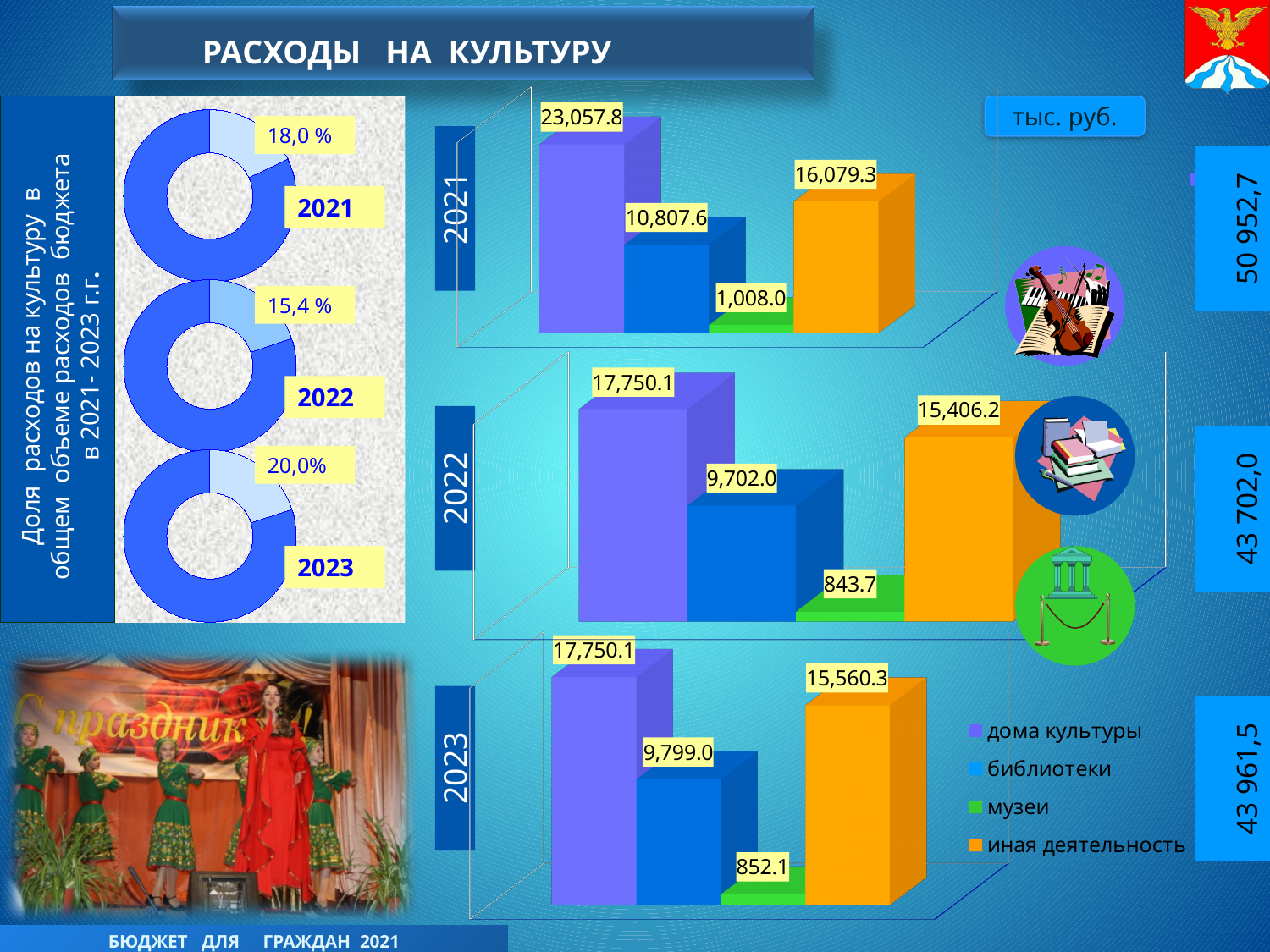
In the 2023 bar chart, what is the value for музеи? 852.1 In the 2022 bar chart, which category has the lowest value? музеи In the 2021 bar chart, what is the value for дома культуры? 23,057.8 In the 2021 bar chart, which category has the highest value? дома культуры What kind of chart is used to show the 2022 culture expenditures by category? bar chart In the donut chart for 2023, what share of total budget expenditures goes to culture? 20,0% In the 2023 bar chart, which is larger: библиотеки or иная деятельность? иная деятельность In the 2023 bar chart, what is the value for иная деятельность? 15,560.3 In the donut chart for 2022, what share of total budget expenditures goes to culture? 15,4 % In the 2021 bar chart, what is the difference between дома культуры and иная деятельность? 6,978.5 How many series does the legend of the bar charts list? 4 In the 2022 bar chart, what is the value for библиотеки? 9,702.0